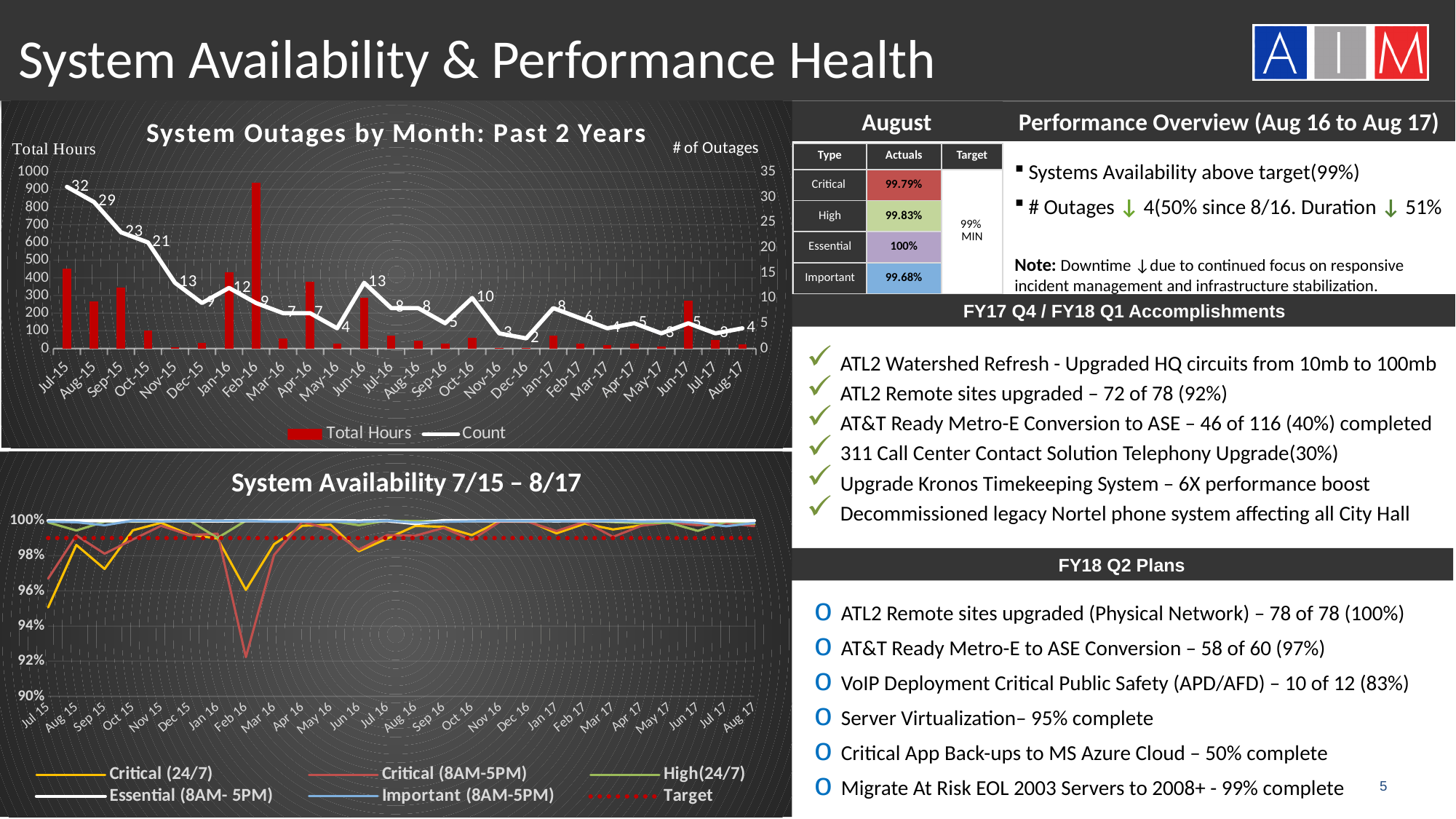
In the 'System Outages by Month: Past 2 Years' chart, what is the difference between the Count for Jul-15 and Aug-15? 3 In the 'System Outages by Month: Past 2 Years' chart, what kind of chart is it? A combination bar and line chart In the 'System Availability 7/15 – 8/17' chart, how many series does the legend list? 6 In the 'System Outages by Month: Past 2 Years' chart, which month has the larger Count, May-16 or Jun-16? Jun-16 In the 'System Outages by Month: Past 2 Years' chart, which month has the highest Count? Jul-15 In the 'System Outages by Month: Past 2 Years' chart, does the Count generally rise or fall from Jul-15 to Aug-17? Fall In the 'System Outages by Month: Past 2 Years' chart, what is the Count value for Aug-17? 4 In the 'System Outages by Month: Past 2 Years' chart, which month has the lowest Count? Dec-16 In the 'System Outages by Month: Past 2 Years' chart, how many series does the legend list? 2 In the 'System Outages by Month: Past 2 Years' chart, is the Total Hours value for Feb-16 greater or less than 800? greater In the 'System Outages by Month: Past 2 Years' chart, what is the Count value for Jul-15? 32 In the 'System Availability 7/15 – 8/17' chart, is the Critical (8AM-5PM) value for Feb 16 greater or less than 94%? less